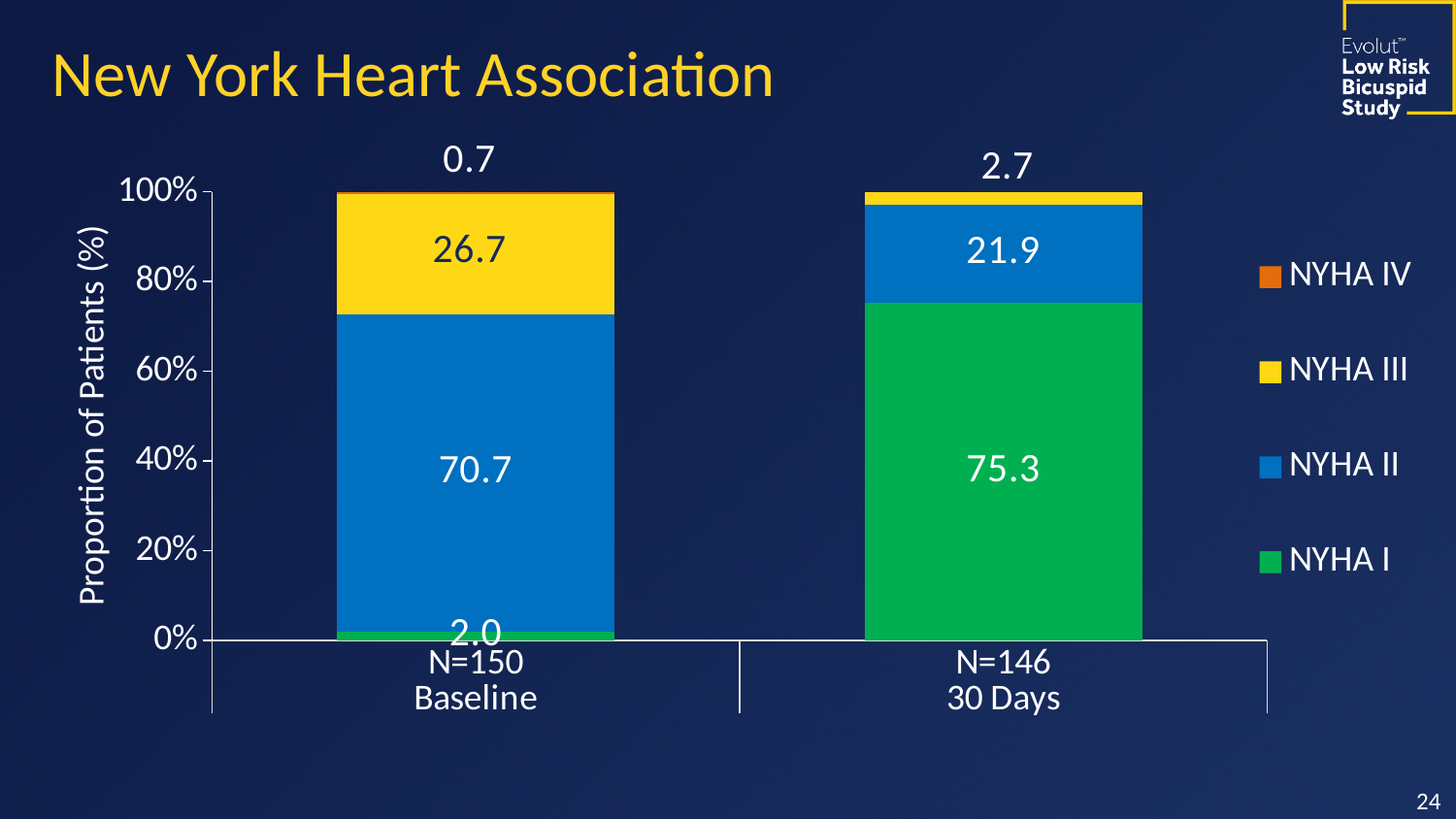
Is the NYHA I value larger at Baseline or at 30 Days? 30 Days What is the value for NYHA II at Baseline? 70.7 How many series does the legend list? 4 What is the value for NYHA IV at Baseline? 0.7 How many time points (categories) are plotted on the x axis? 2 Does the NYHA I proportion rise or fall from Baseline to 30 Days? Rise What kind of chart is shown on the slide? Stacked bar chart What is the y-axis title of the chart? Proportion of Patients (%) What is the value for NYHA III at Baseline? 26.7 What is the value for NYHA I at 30 Days? 75.3 What is the value for NYHA II at 30 Days? 21.9 What is the difference between the NYHA II value at Baseline and at 30 Days? 48.8